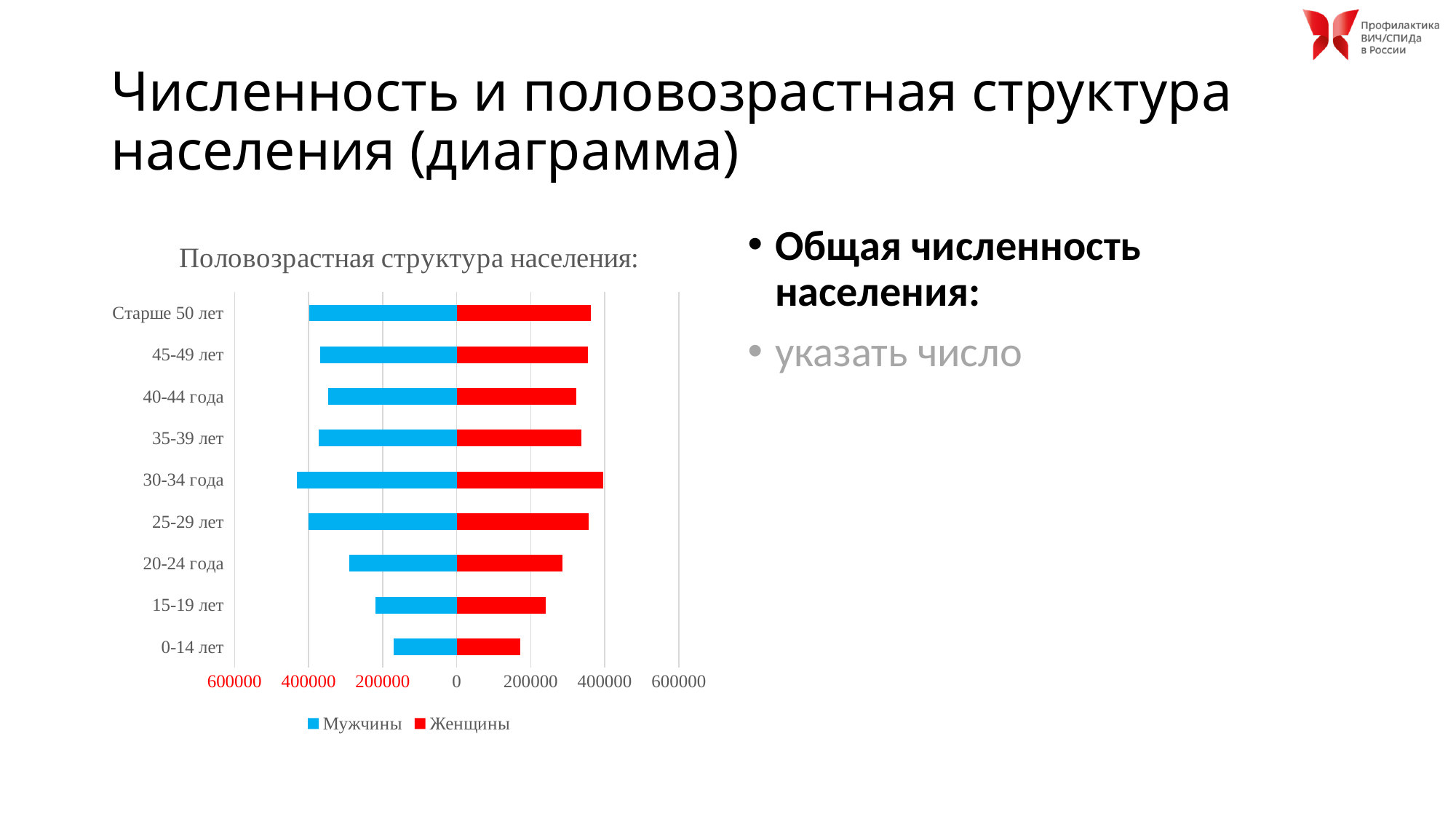
Which is larger for Женщины: the 20-24 года group or the 15-19 лет group? 20-24 года Is the value for Мужчины in the 0-14 лет group greater or less than 200000? less What are the two series named in the chart legend? Мужчины, Женщины How many series does the chart legend list? 2 How many age groups are shown on the chart? 9 Which age group has the lowest value for Мужчины? 0-14 лет Is the value for Мужчины in the 30-34 года group greater or less than 400000? greater What kind of chart is shown on the slide? bar chart Is the value for Женщины in the 20-24 года group greater or less than 200000? greater Which age group has the highest value for Мужчины? 30-34 года What is the title of the chart? Половозрастная структура населения: Which age group has the lowest value for Женщины? 0-14 лет